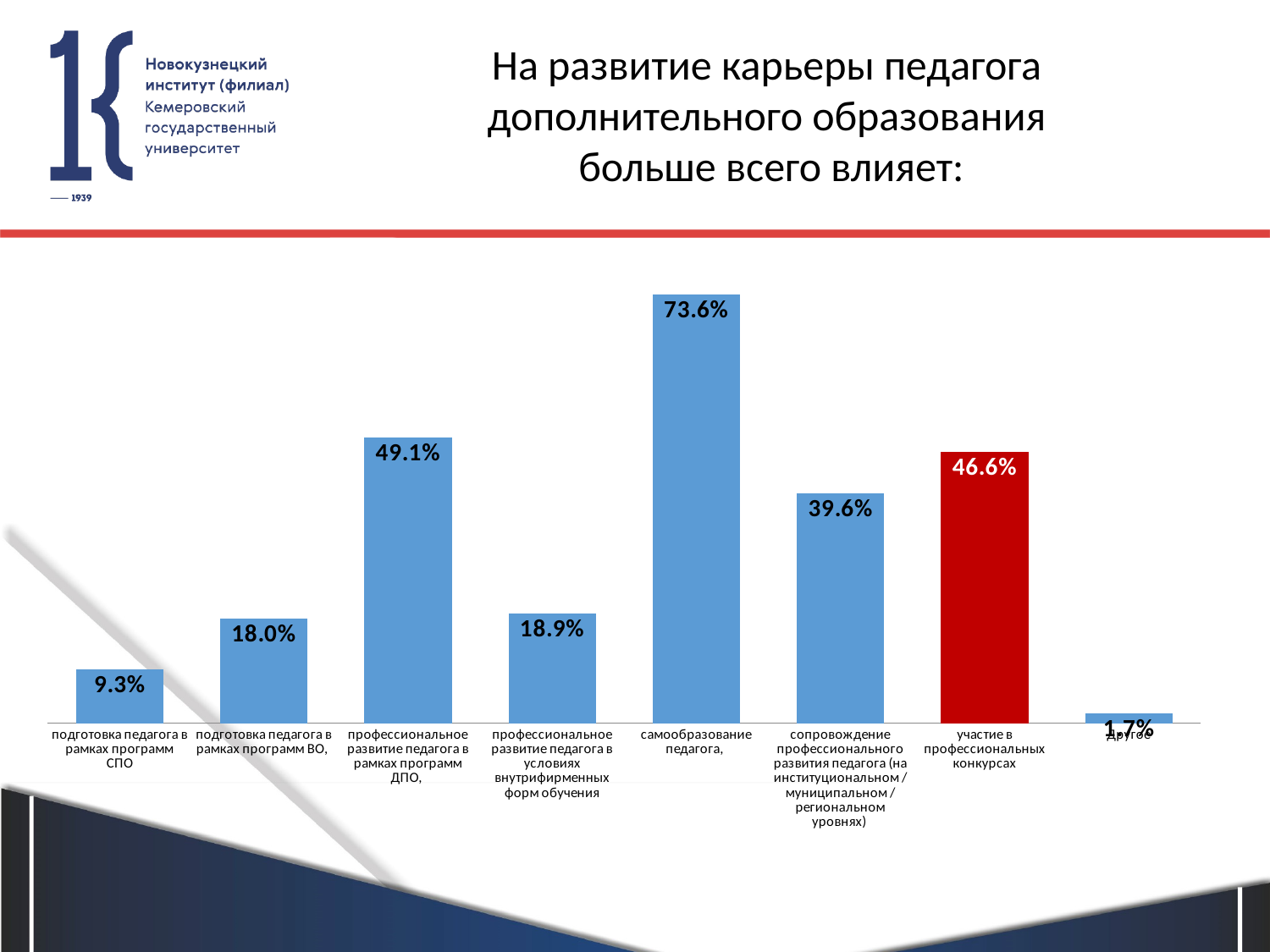
Which category has the lowest value? другое What is the difference between the values for "подготовка педагога в рамках программ ВО" and "подготовка педагога в рамках программ СПО"? 8.7% What value is shown for "участие в профессиональных конкурсах"? 46.6% What value is shown for "подготовка педагога в рамках программ СПО"? 9.3% Which bar is coloured red rather than blue? участие в профессиональных конкурсах Which is larger: the value for "участие в профессиональных конкурсах" or the value for "сопровождение профессионального развития педагога"? участие в профессиональных конкурсах What kind of chart is shown on the slide? bar chart What is the difference between the values for "самообразование педагога" and "профессиональное развитие педагога в рамках программ ДПО"? 24.5% What value is shown for "профессиональное развитие педагога в рамках программ ДПО"? 49.1% How many categories are shown in the chart? 8 What value is shown for "самообразование педагога"? 73.6% Which category has the highest value? самообразование педагога